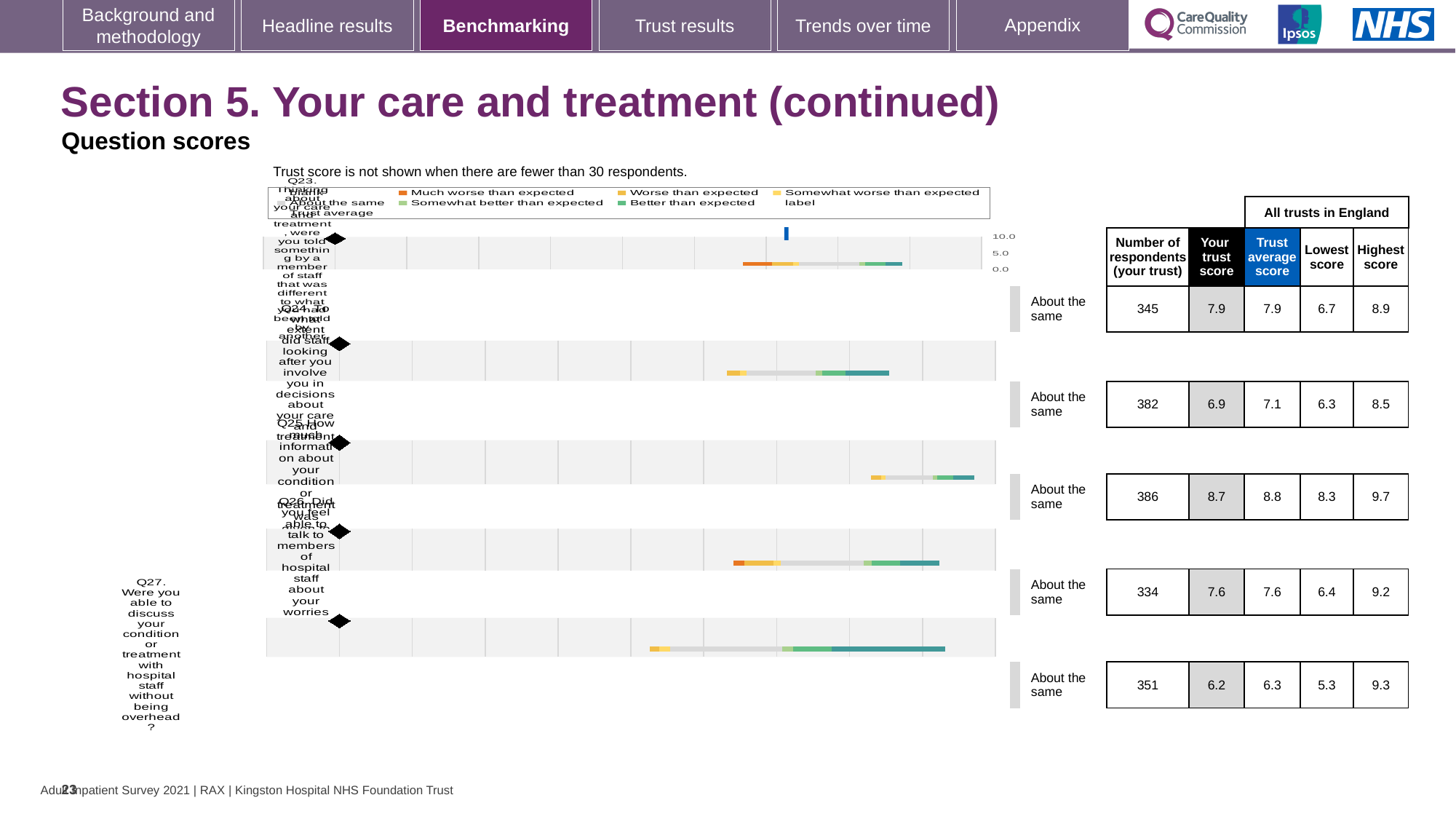
What is the trust average score for Q26 (Did you feel able to talk to members of hospital staff about your worries)? 7.6 What is the lowest score across all trusts in England for Q23? 6.7 Which question has the lowest 'Your trust score'? Q27 Which has the larger 'Your trust score', Q23 or Q26? Q23 What is the difference between the trust average score and your trust score for Q24? 0.2 What is the highest score across all trusts in England for Q27 (Were you able to discuss your condition or treatment with hospital staff without being overheard)? 9.3 What is the 'Your trust score' value for Q25 (How much information about your condition or treatment was given to you)? 8.7 What is the difference between the highest score and the lowest score for Q27? 4.0 How many respondents from your trust answered Q24 (To what extent did staff looking after you involve you in decisions about your care and treatment)? 382 How many questions are shown on the chart? 5 What benchmark category is shown for Q27? About the same Which question has the highest 'Your trust score'? Q25